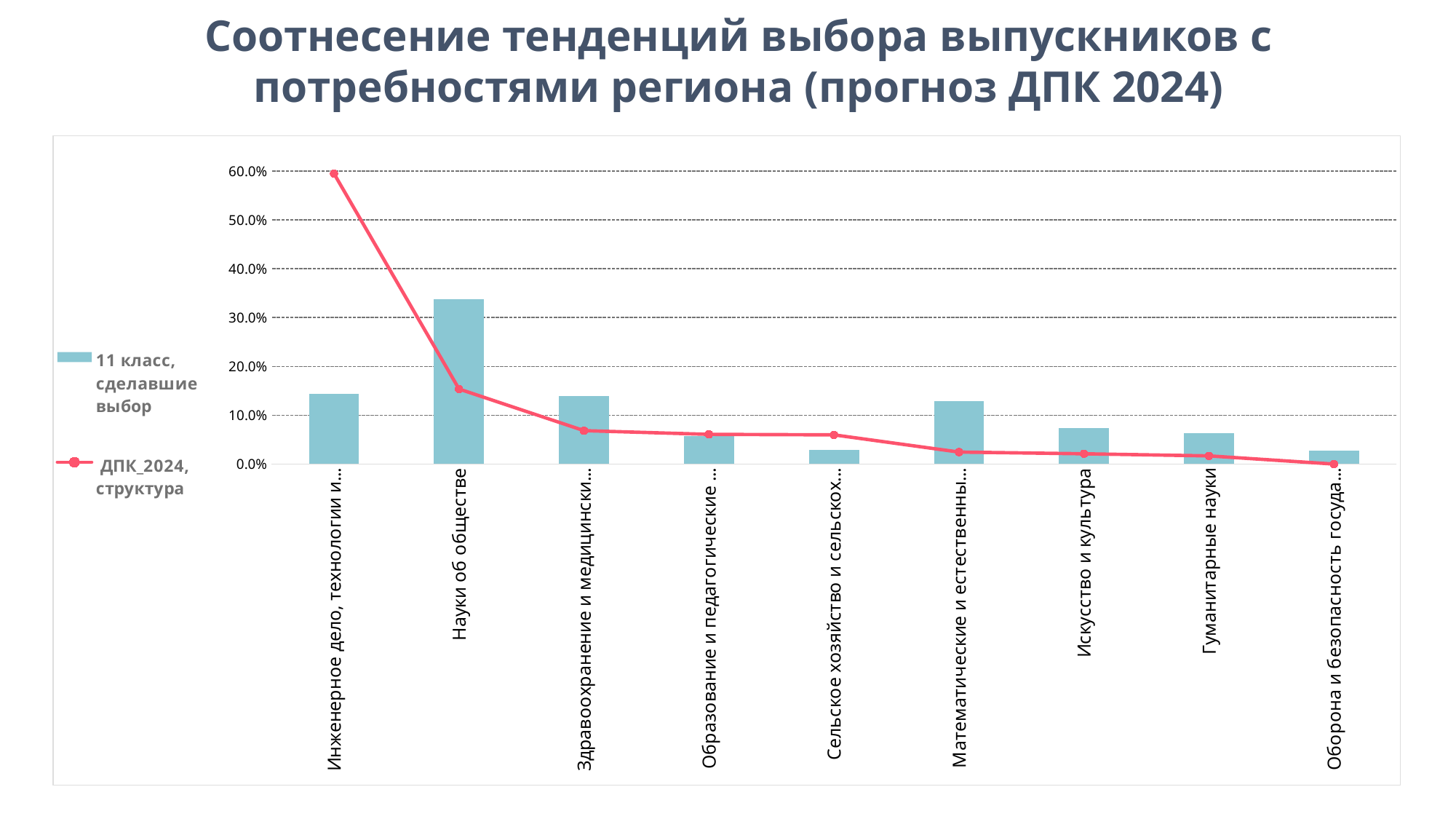
Does the "ДПК_2024, структура" line generally rise or fall from left to right? Fall Which category has the lowest point on the "ДПК_2024, структура" line? Оборона и безопасность госуда... How many series does the legend list? 2 Is the "ДПК_2024, структура" value for "Инженерное дело, технологии и..." greater or less than 50.0%? greater How many categories are shown along the x axis? 9 Which category has the highest point on the "ДПК_2024, структура" line? Инженерное дело, технологии и... Which category has the highest bar for "11 класс, сделавшие выбор"? Науки об обществе For "Инженерное дело, технологии и...", which is larger: the "11 класс, сделавшие выбор" bar or the "ДПК_2024, структура" point? ДПК_2024, структура What colour are the bars for "11 класс, сделавшие выбор"? Light blue Is the "11 класс, сделавшие выбор" bar for "Науки об обществе" greater or less than 30.0%? greater Is the "11 класс, сделавшие выбор" bar for "Искусство и культура" greater or less than 10.0%? less What kind of chart is shown on the slide? A combined bar and line chart